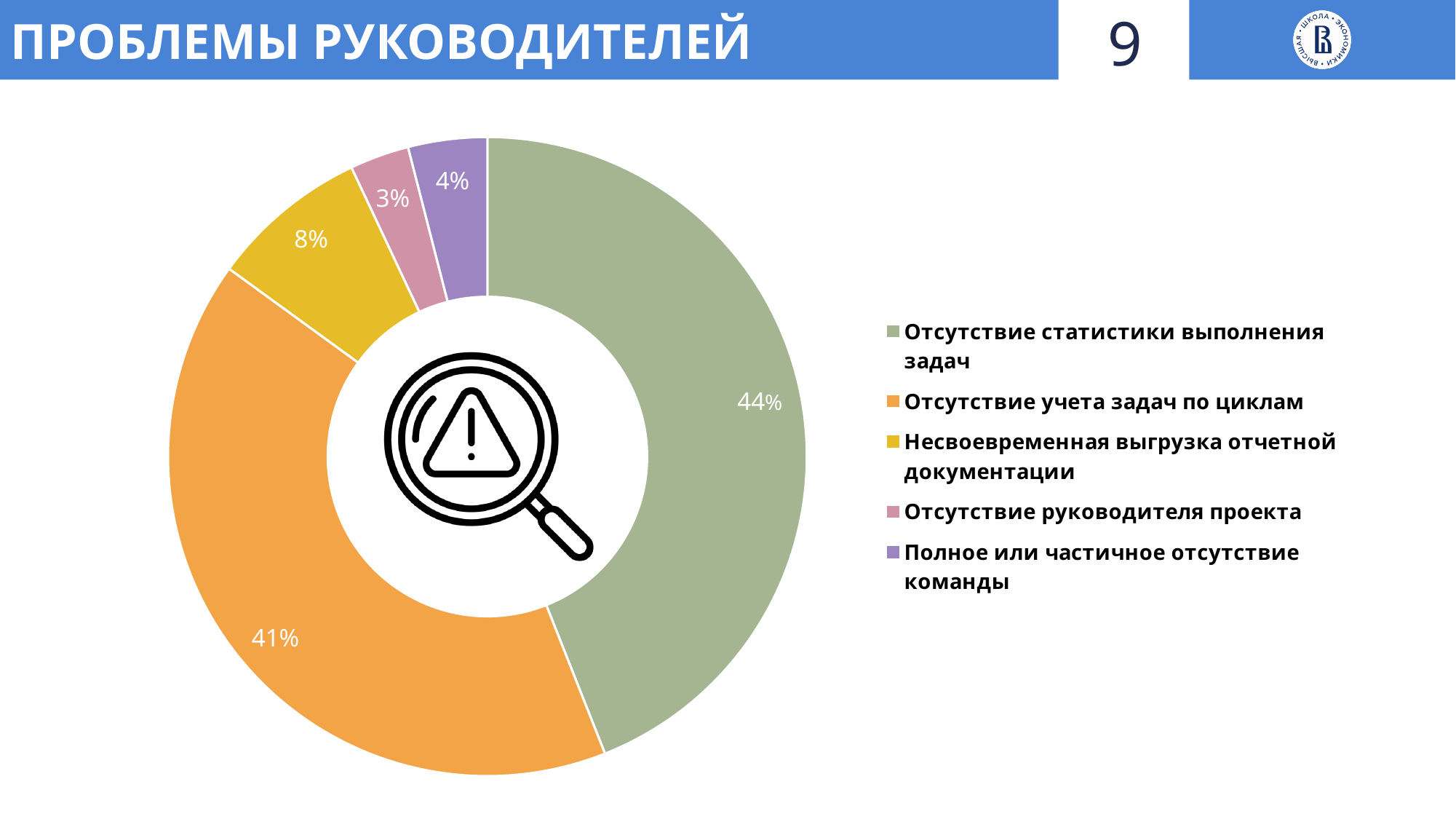
What is the difference in percentage points between "Отсутствие статистики выполнения задач" and "Отсутствие учета задач по циклам"? 3 What share of the pie does "Отсутствие статистики выполнения задач" have? 44% Which category has the largest share of the pie? Отсутствие статистики выполнения задач Which is larger: the share for "Несвоевременная выгрузка отчетной документации" or the share for "Полное или частичное отсутствие команды"? Несвоевременная выгрузка отчетной документации What share of the pie does "Отсутствие учета задач по циклам" have? 41% What share of the pie does "Несвоевременная выгрузка отчетной документации" have? 8% How many categories does the pie chart show? 5 Which category has the smallest share of the pie? Отсутствие руководителя проекта What share of the pie does "Отсутствие руководителя проекта" have? 3% What kind of chart is shown on the slide? Doughnut chart What share of the pie does "Полное или частичное отсутствие команды" have? 4% What colour is the slice for "Отсутствие учета задач по циклам"? Orange